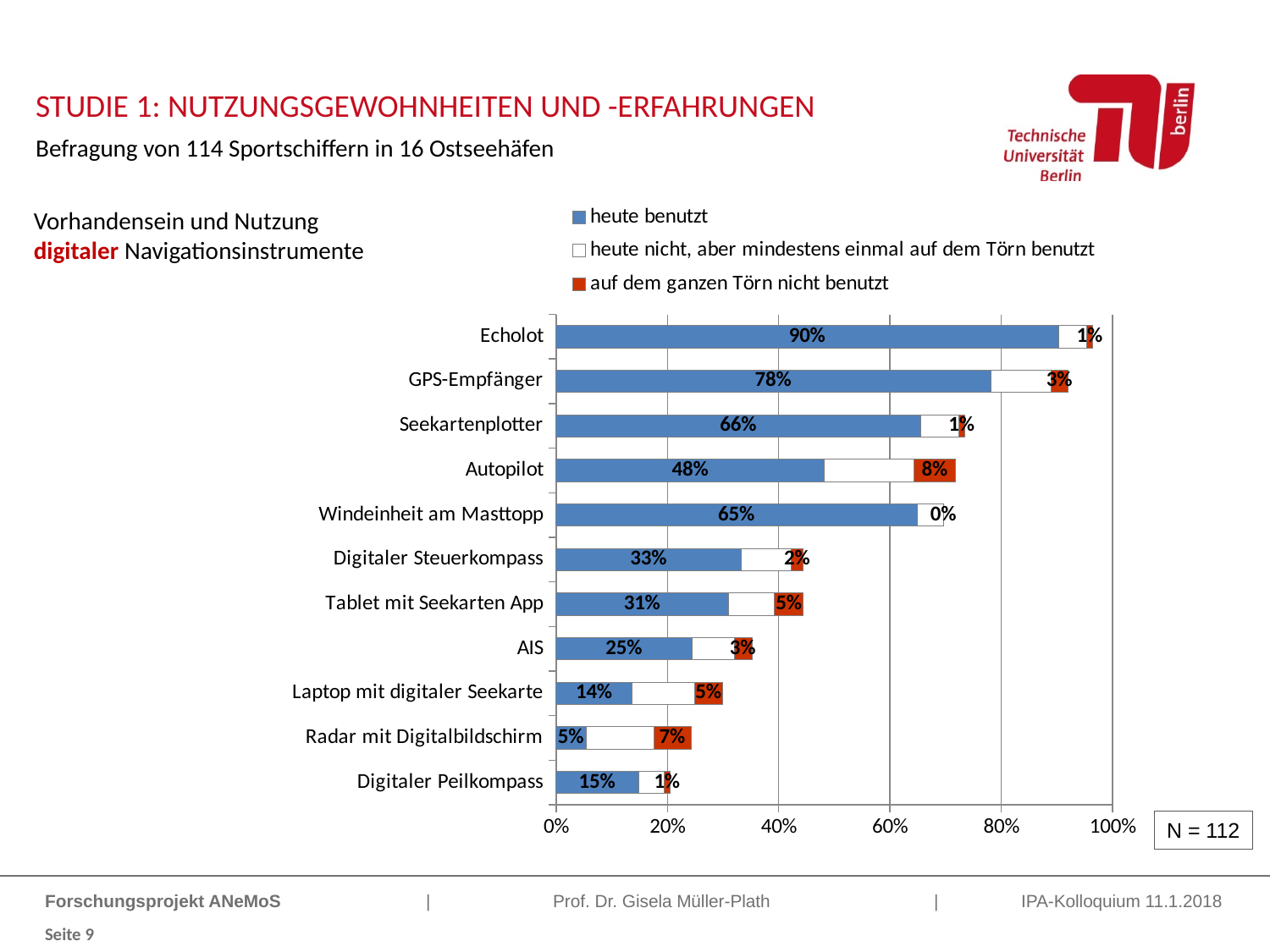
Which has the larger "heute benutzt" value, Autopilot or Windeinheit am Masttopp? Windeinheit am Masttopp What is the "heute benutzt" value for Echolot? 90% What kind of chart is shown on the slide? Stacked bar chart How many categories (navigation instruments) are shown in the chart? 11 What is the "auf dem ganzen Törn nicht benutzt" value for Autopilot? 8% Which category has the highest "heute benutzt" value? Echolot What sample size (N) is stated next to the chart? N = 112 What is the difference between the "heute benutzt" values for GPS-Empfänger and Seekartenplotter? 12% Which category has the lowest "heute benutzt" value? Radar mit Digitalbildschirm How many series does the legend list? 3 What is the "heute benutzt" value for Tablet mit Seekarten App? 31% Which category has the highest "auf dem ganzen Törn nicht benutzt" value? Autopilot